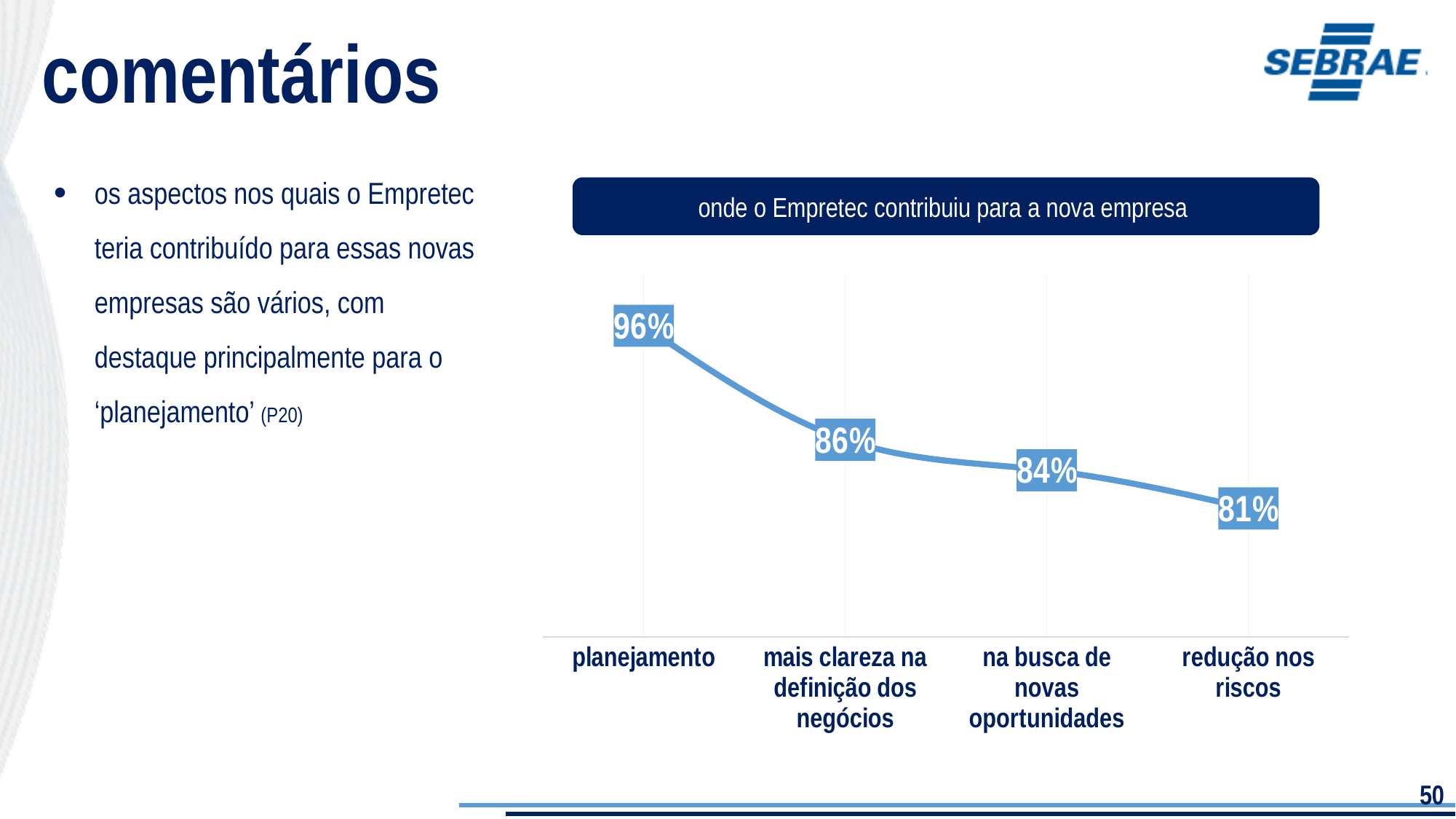
Which category has the lowest value? redução nos riscos Do the values rise or fall from left to right along the x axis? fall What is the value for 'redução nos riscos'? 81% What is the difference between the values for 'mais clareza na definição dos negócios' and 'na busca de novas oportunidades'? 2% What is the value for 'planejamento'? 96% What kind of chart is shown on the slide? line chart What is the value for 'mais clareza na definição dos negócios'? 86% Which is larger, the value for 'planejamento' or the value for 'mais clareza na definição dos negócios'? planejamento What is the value for 'na busca de novas oportunidades'? 84% How many categories are plotted on the chart? 4 What is the difference between the values for 'planejamento' and 'redução nos riscos'? 15% Which category has the highest value? planejamento